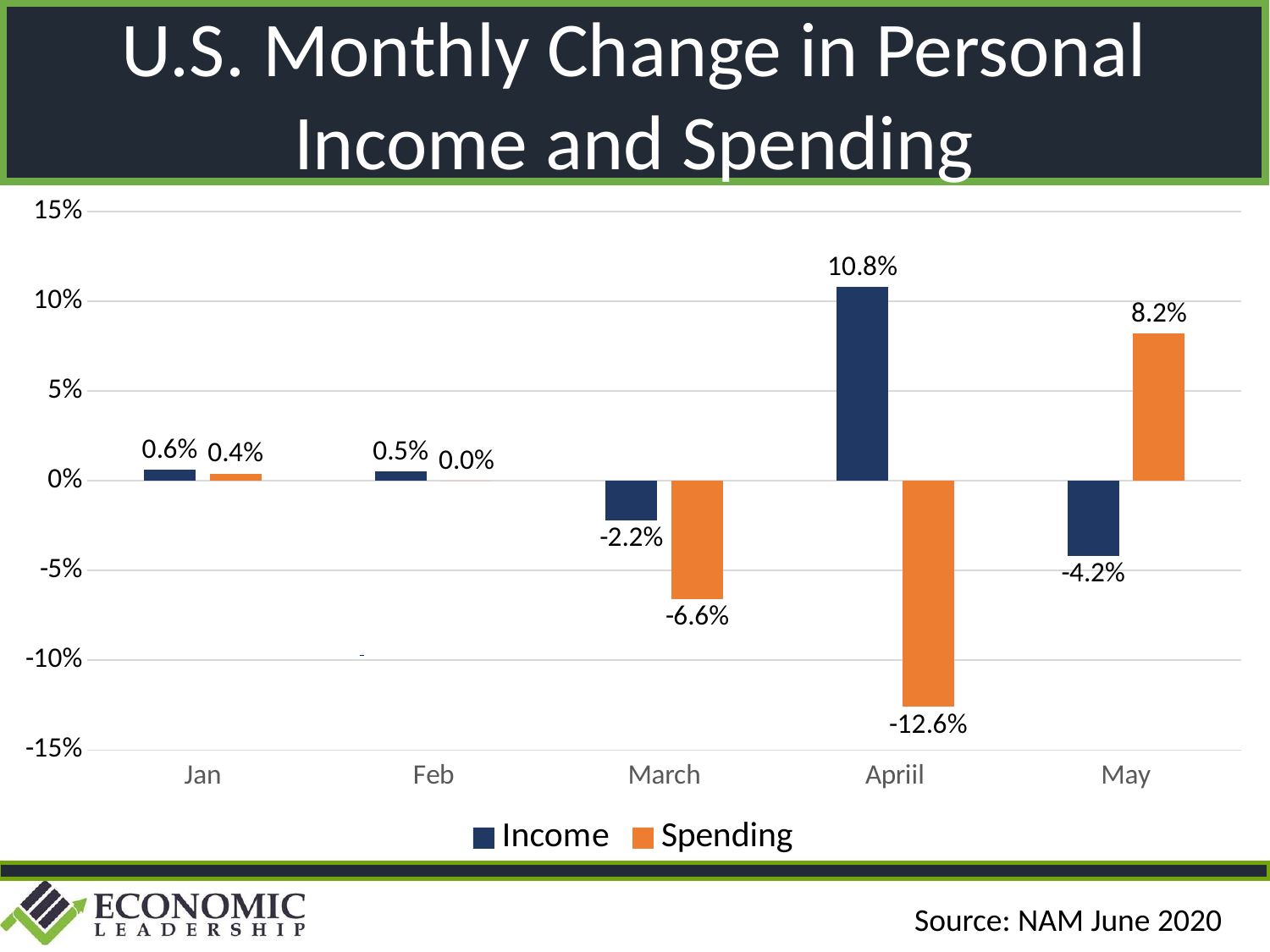
How many months are shown on the x axis? 5 What is the Income value for March? -2.2% What kind of chart is shown on the slide? Bar chart Which month has the highest Income value? April What is the difference between the Income and Spending values for May? 12.4 percentage points What is the Spending value for April? -12.6% What is the Income value for April? 10.8% What is the source cited at the bottom of the slide? NAM June 2020 How many series does the legend list? 2 What is the Spending value for May? 8.2% Which is larger in March, the Income value or the Spending value? Income Which month has the lowest Spending value? April